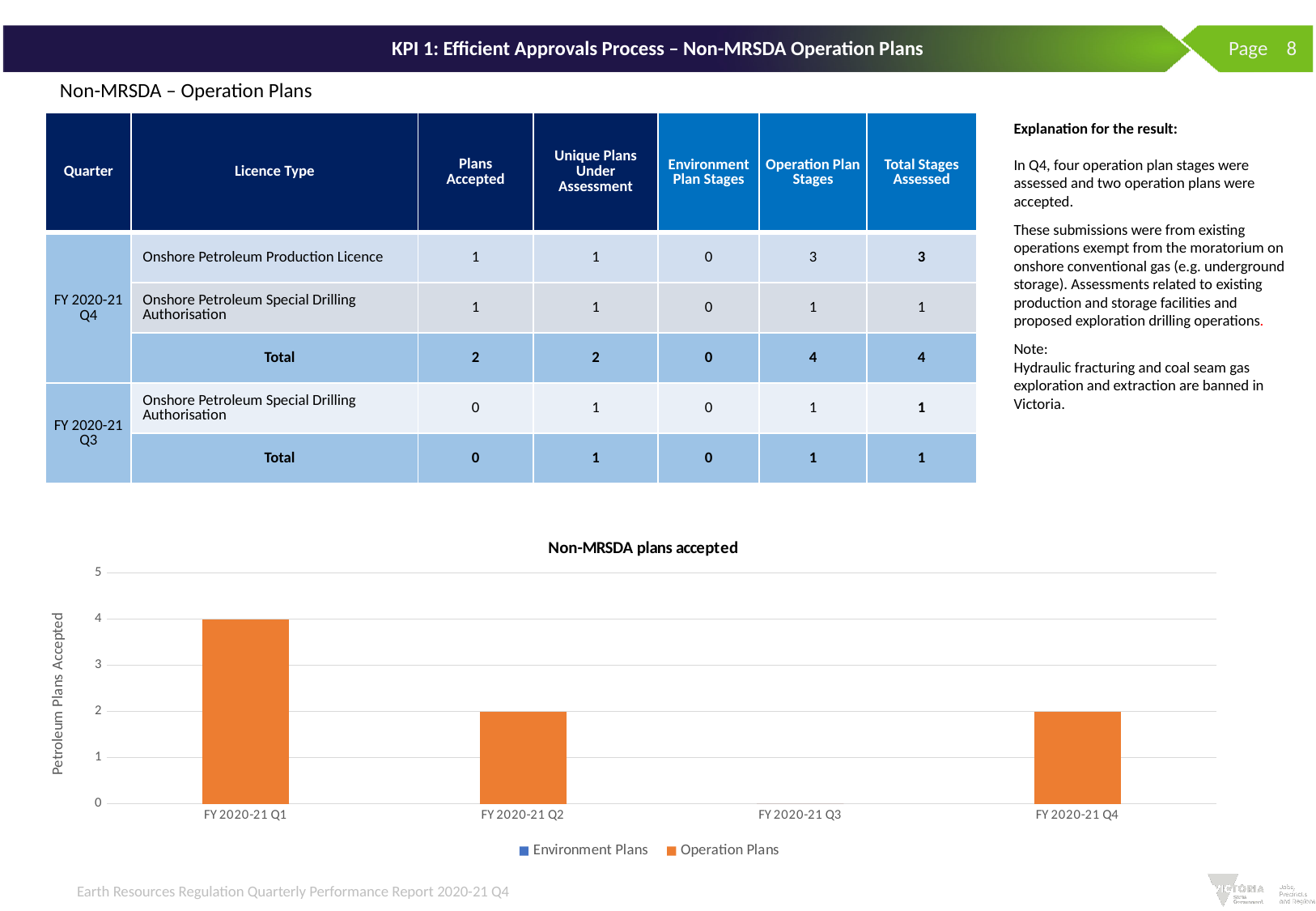
How many quarters are shown on the x axis of the chart? 4 How many series does the chart legend list? 2 What kind of chart is shown on the slide? bar chart What is the difference between Operation Plans accepted in FY 2020-21 Q1 and FY 2020-21 Q2? 2 Which is larger, Operation Plans accepted in FY 2020-21 Q1 or in FY 2020-21 Q4? FY 2020-21 Q1 Which quarter has the lowest number of Operation Plans accepted? FY 2020-21 Q3 What is the title of the chart? Non-MRSDA plans accepted Which quarter has the highest number of Operation Plans accepted? FY 2020-21 Q1 What is the value of Operation Plans accepted for FY 2020-21 Q2? 2 What is the value of Operation Plans accepted for FY 2020-21 Q4? 2 What is the value of Operation Plans accepted for FY 2020-21 Q1? 4 Is the value for Operation Plans accepted in FY 2020-21 Q1 greater or less than 3? greater